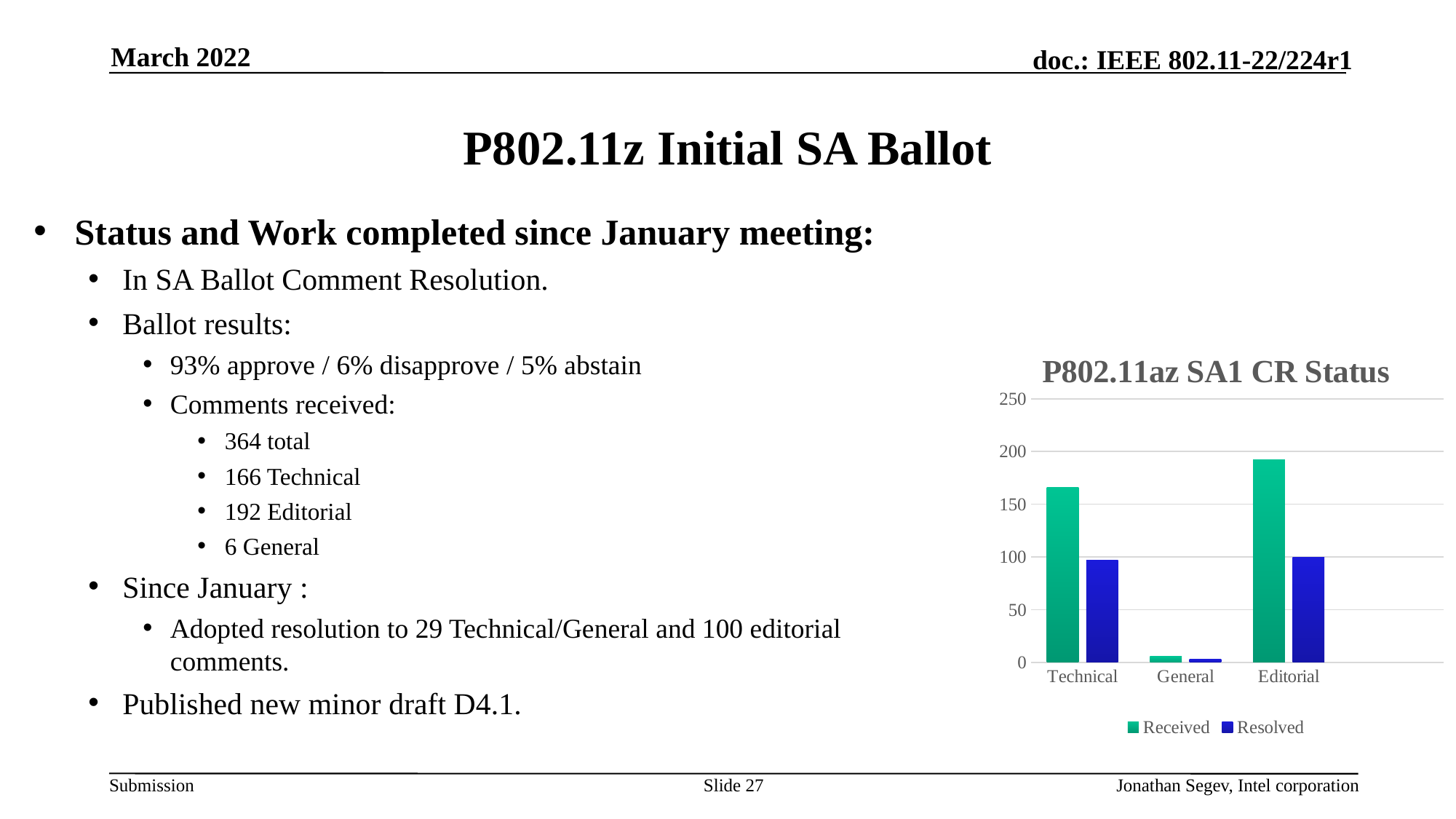
Which category has the highest Received value? Editorial What is the title of the chart? P802.11az SA1 CR Status Which category has the lowest Resolved value? General Which series is shown in blue in the chart? Resolved How many series does the chart legend list? 2 Is the Received value for Technical greater or less than 150? greater Which is larger for Editorial: the Received value or the Resolved value? Received Which category has the lowest Received value? General What kind of chart is shown on the slide? bar chart How many categories are shown on the x axis of the chart? 3